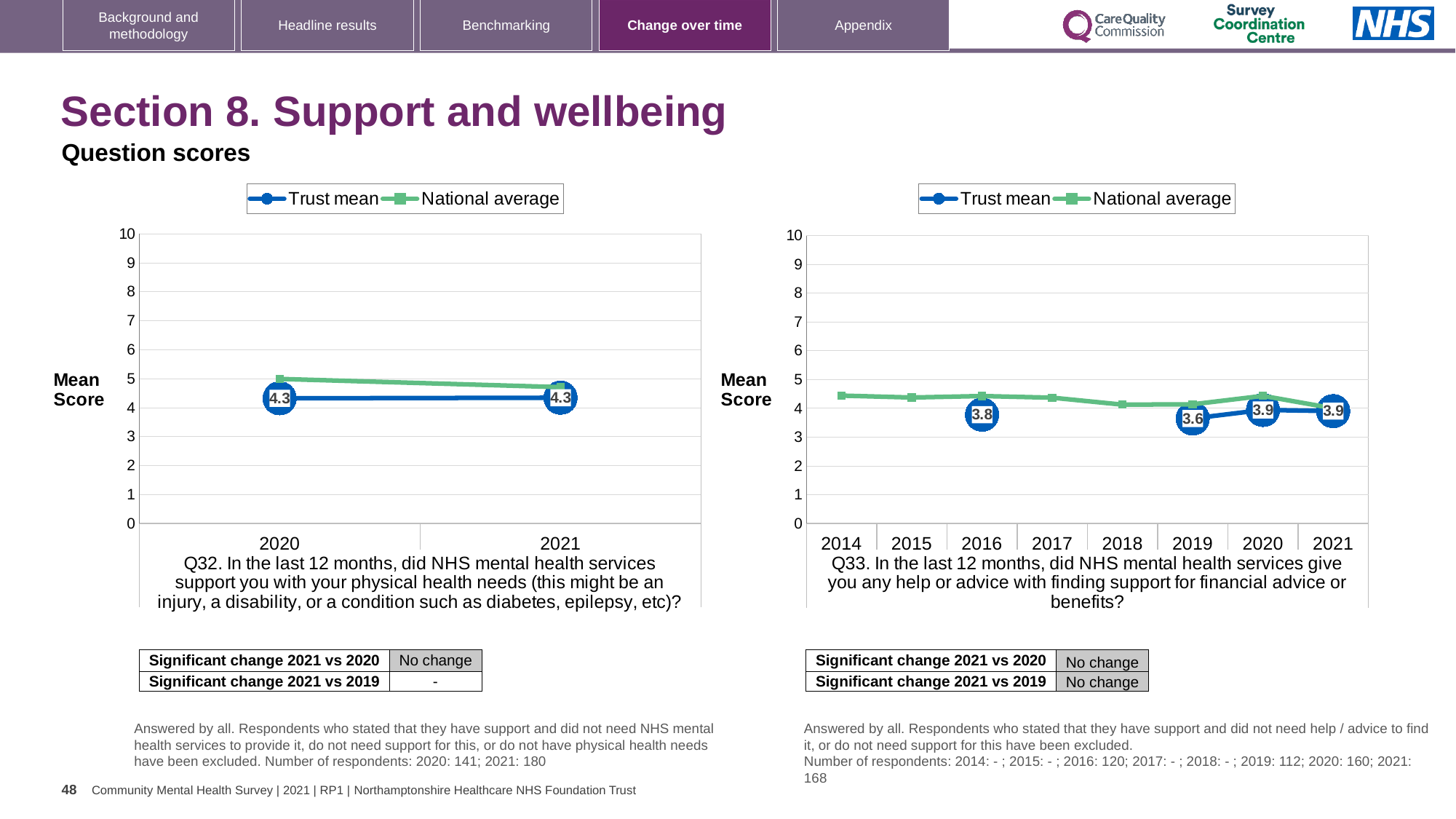
How many series does the legend of the left chart (Q32) list? 2 On the right chart (Q33), which is larger, the Trust mean for 2019 or the Trust mean for 2021? 2021 What type of chart is the right chart (Q33)? Line chart On the right chart (Q33), what is the Trust mean score for 2019? 3.6 On the right chart (Q33), what is the Trust mean score for 2016? 3.8 On the left chart (Q32), is the National average value for 2020 greater or less than 4? greater How many years are shown on the x axis of the right chart (Q33)? 8 On the left chart (Q32), does the Trust mean rise, fall or stay the same from 2020 to 2021? Stays the same On the right chart (Q33), which year has the lowest labelled Trust mean score? 2019 On the left chart (Q32), what is the Trust mean score for 2020? 4.3 On the left chart (Q32), what is the Trust mean score for 2021? 4.3 On the right chart (Q33), what is the difference between the Trust mean scores for 2020 and 2019? 0.3